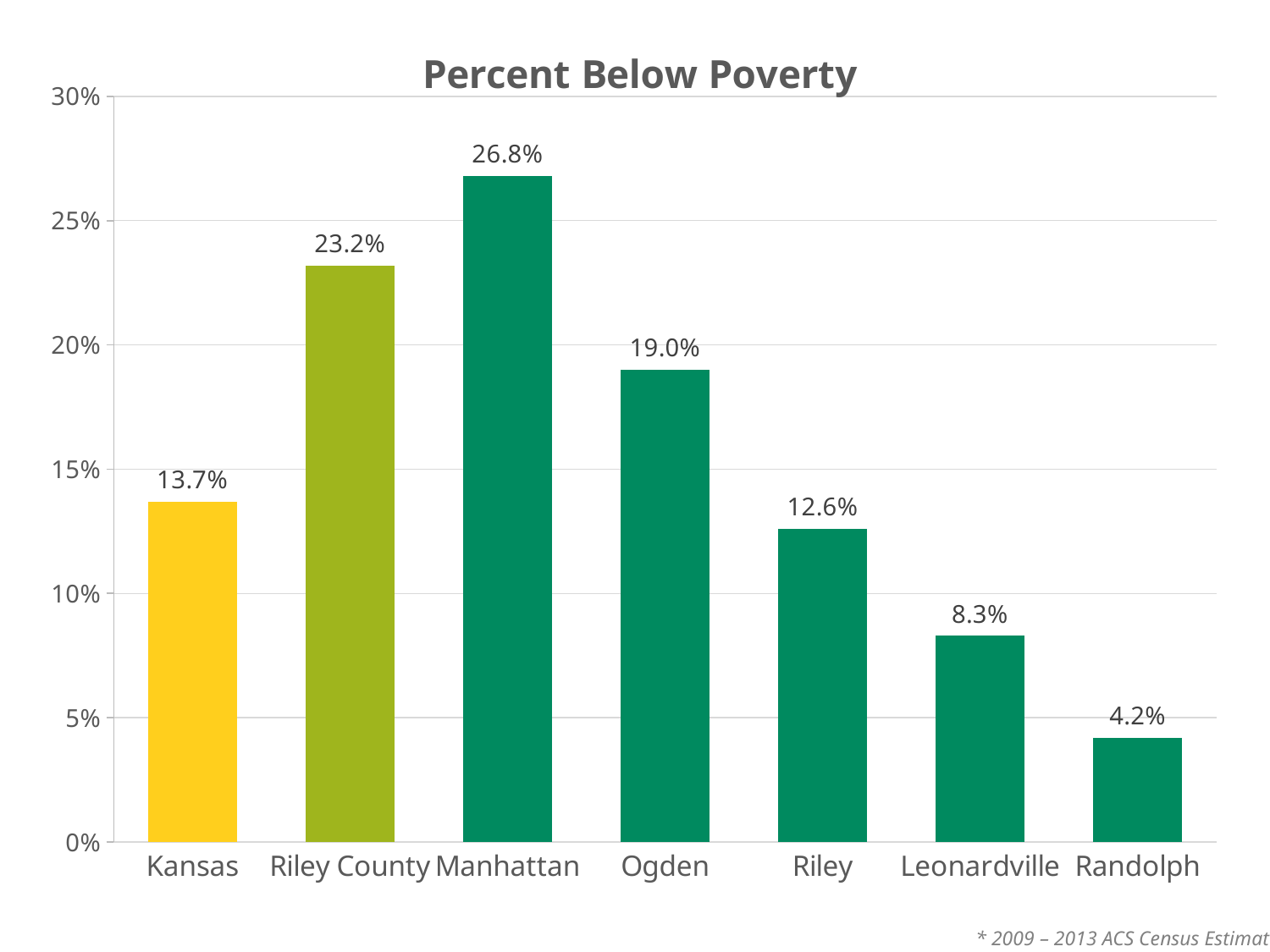
What is the difference in percent below poverty between Manhattan and Ogden? 7.8% Which has a higher percent below poverty, Riley or Ogden? Ogden What type of chart is shown on the slide? Bar chart What is the difference in percent below poverty between Riley County and Kansas? 9.5% Which category has the highest percent below poverty? Manhattan How many categories are shown in the chart? 7 Is the value for Riley County greater or less than 20%? greater What is the title of the chart? Percent Below Poverty Which category has the lowest percent below poverty? Randolph What is the percent below poverty for Leonardville? 8.3% What is the percent below poverty for Kansas? 13.7% What is the percent below poverty for Manhattan? 26.8%